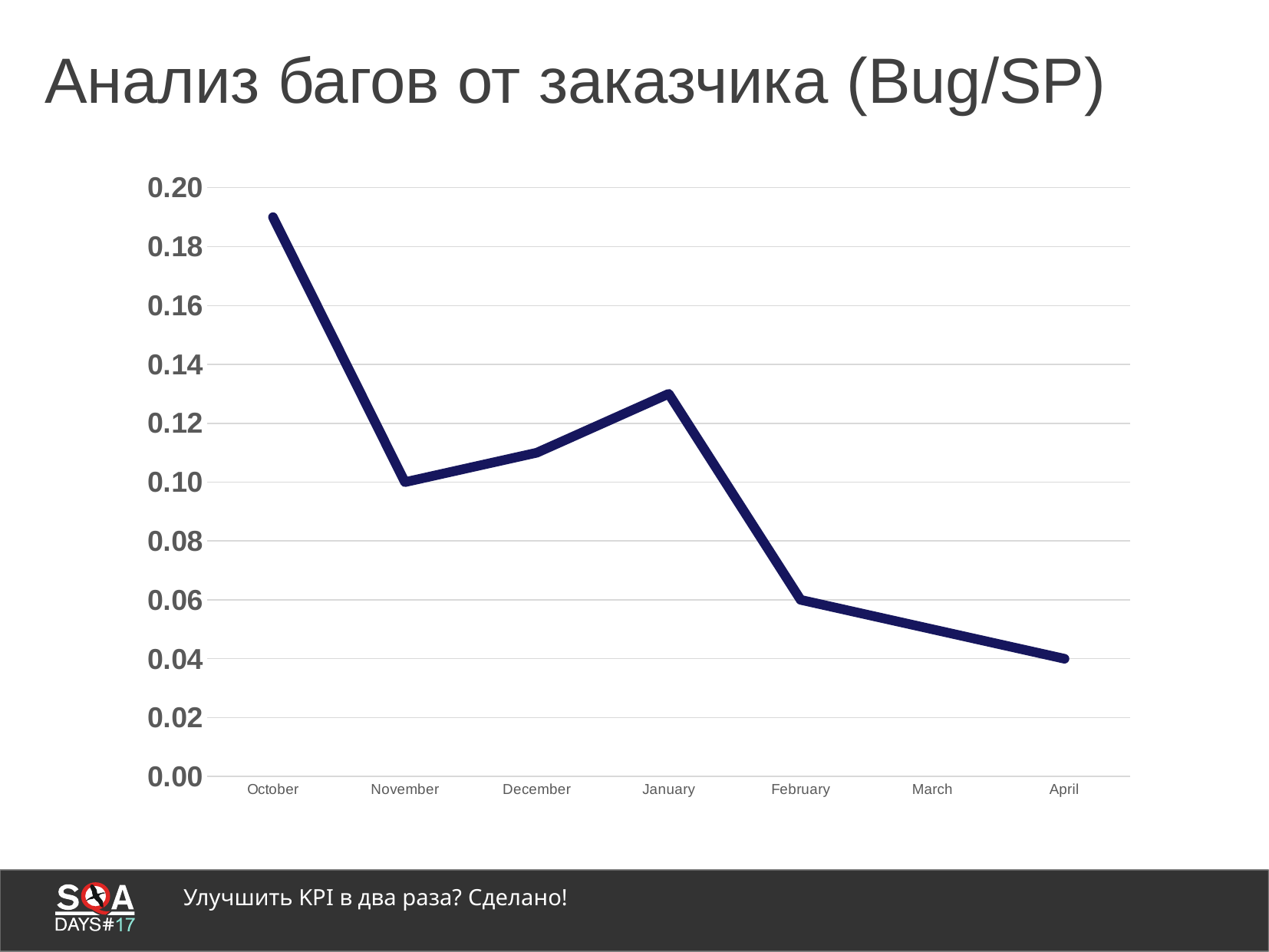
Which month has the highest value? October What is the difference between the values for November and April? 0.06 What is the value for April? 0.04 Is the value for October greater or less than 0.18? greater Which is larger, the value for January or the value for December? January What is the value for November? 0.10 Which month has the lowest value? April Overall, do the values rise or fall from October to April? fall What is the title of the slide containing the chart? Анализ багов от заказчика (Bug/SP) How many months are plotted along the x axis? 7 What kind of chart is shown on the slide? line chart What is the value for February? 0.06